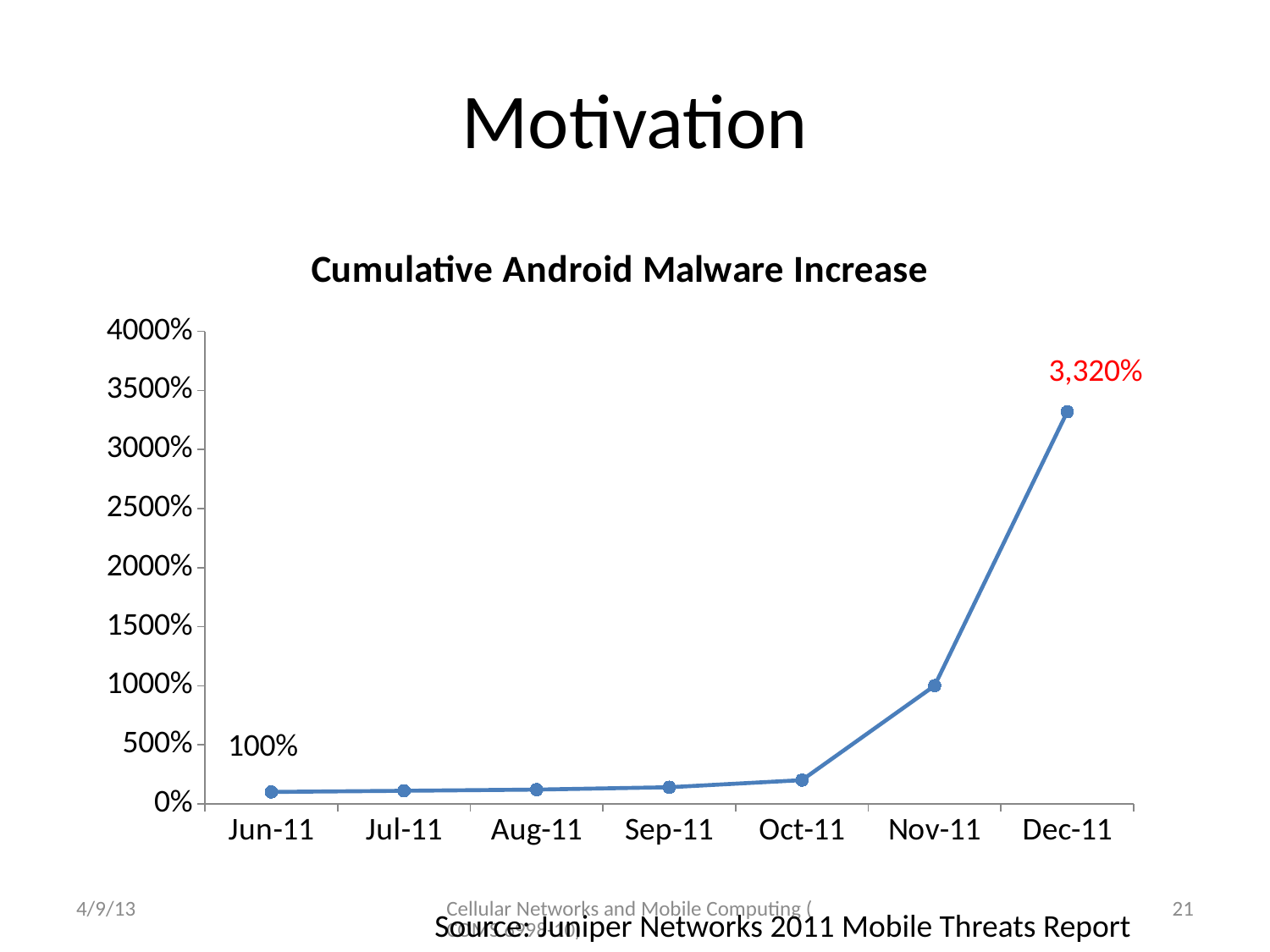
Is the value for Nov-11 greater or less than 500%? greater What is the difference between the Dec-11 value and the Jun-11 value? 3,220% Which is larger, the value for Nov-11 or the value for Oct-11? Nov-11 What is the value for Jun-11? 100% Which month has the highest value? Dec-11 What is the value for Dec-11? 3,320% Do the values rise or fall from Jun-11 to Dec-11? rise What kind of chart is shown on the slide? line chart Is the value for Oct-11 greater or less than 500%? less Which month has the lowest value? Jun-11 What is the title of the chart? Cumulative Android Malware Increase How many months are plotted on the x axis? 7